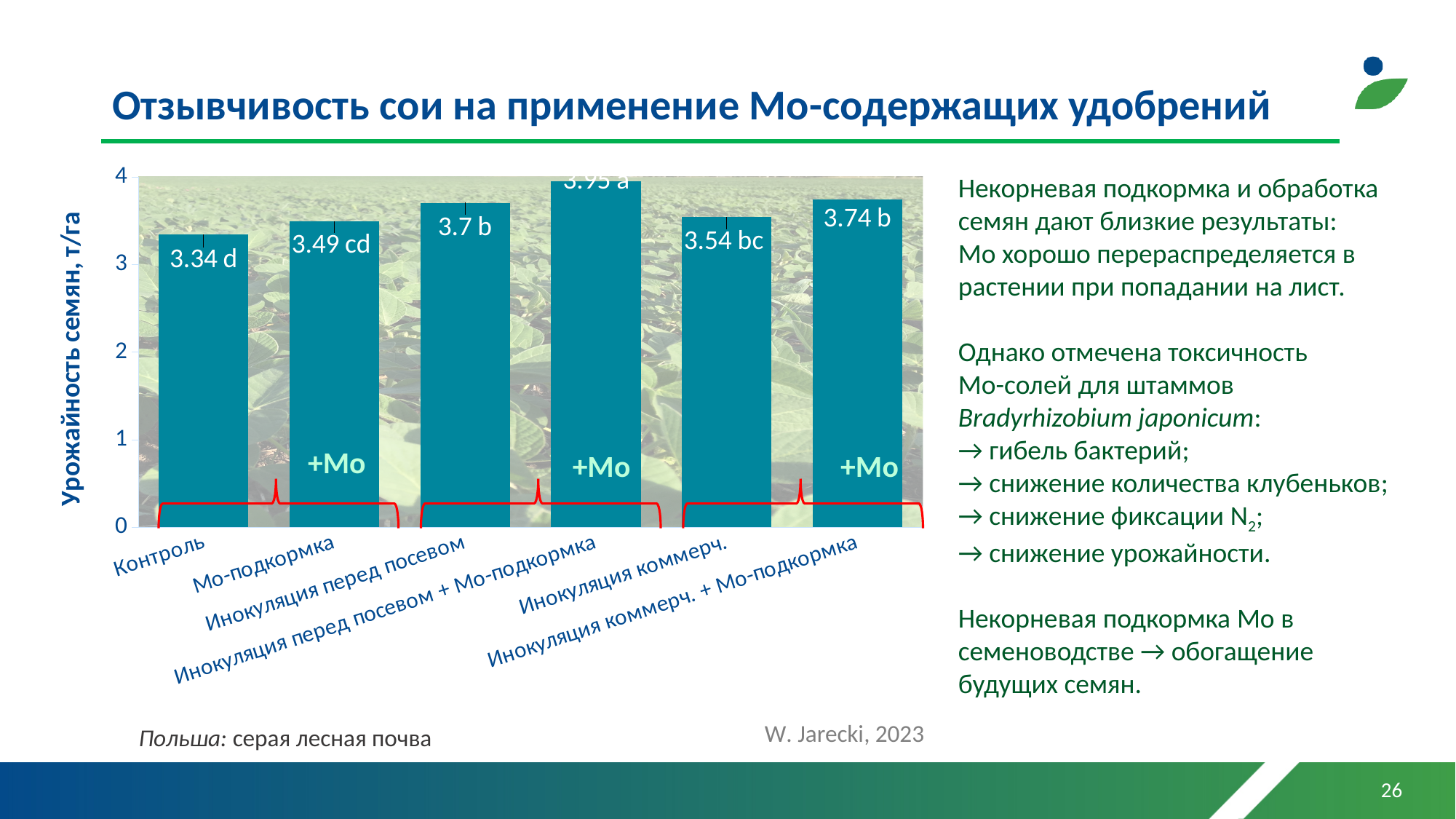
How many treatments (bars) are shown in the chart? 6 Which treatment has the highest seed yield? Инокуляция перед посевом + Mo-подкормка What is the title of the vertical axis? Урожайность семян, т/га What is the difference in seed yield between Инокуляция перед посевом + Mo-подкормка and Контроль? 0.61 Which has a higher seed yield: Mo-подкормка or Инокуляция перед посевом? Инокуляция перед посевом What is the seed yield for Инокуляция коммерч.? 3.54 Is the seed yield for Контроль greater or less than 3? greater What is the difference in seed yield between Инокуляция коммерч. + Mo-подкормка and Инокуляция коммерч.? 0.2 Which treatment has the lowest seed yield? Контроль What type of chart is shown on the slide? bar chart What is the seed yield for Инокуляция перед посевом + Mo-подкормка? 3.95 What is the seed yield for Контроль? 3.34